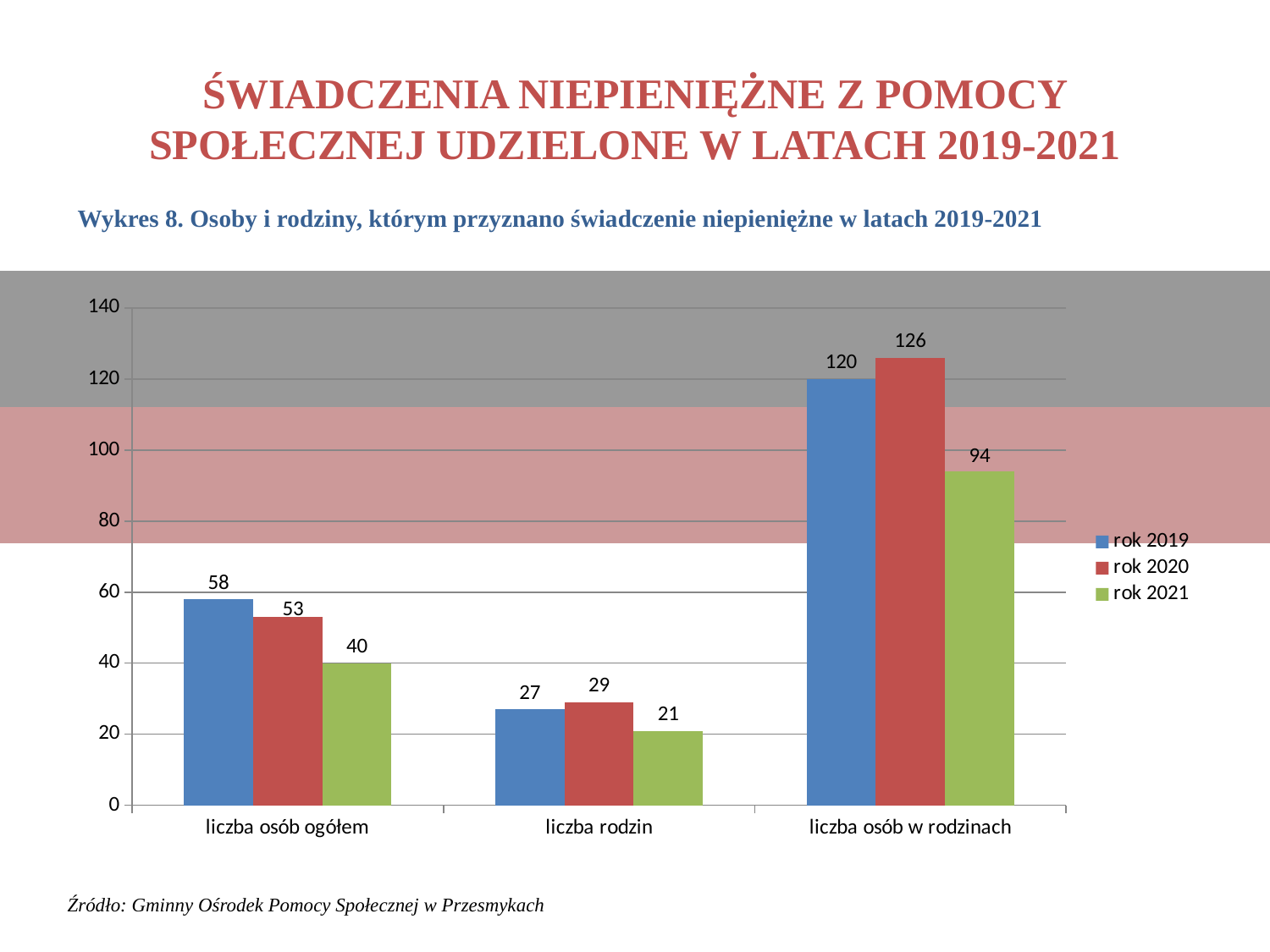
Which category has the lowest value in the 'rok 2019' series? liczba rodzin What is the value for 'liczba rodzin' in the 'rok 2021' series? 21 What is the value for 'liczba osób ogółem' in the 'rok 2019' series? 58 How many series does the legend list? 3 Is the 'rok 2021' value for 'liczba osób w rodzinach' greater or less than 100? less Which category has the highest value in the 'rok 2021' series? liczba osób w rodzinach Which colour represents the 'rok 2020' series in the legend? red Which is larger for 'liczba rodzin': the 'rok 2019' value or the 'rok 2020' value? rok 2020 What is the value for 'liczba osób w rodzinach' in the 'rok 2020' series? 126 What is the difference between the 'rok 2020' and 'rok 2021' values for 'liczba osób w rodzinach'? 32 What kind of chart is shown on the slide? bar chart How many categories are shown on the x axis? 3